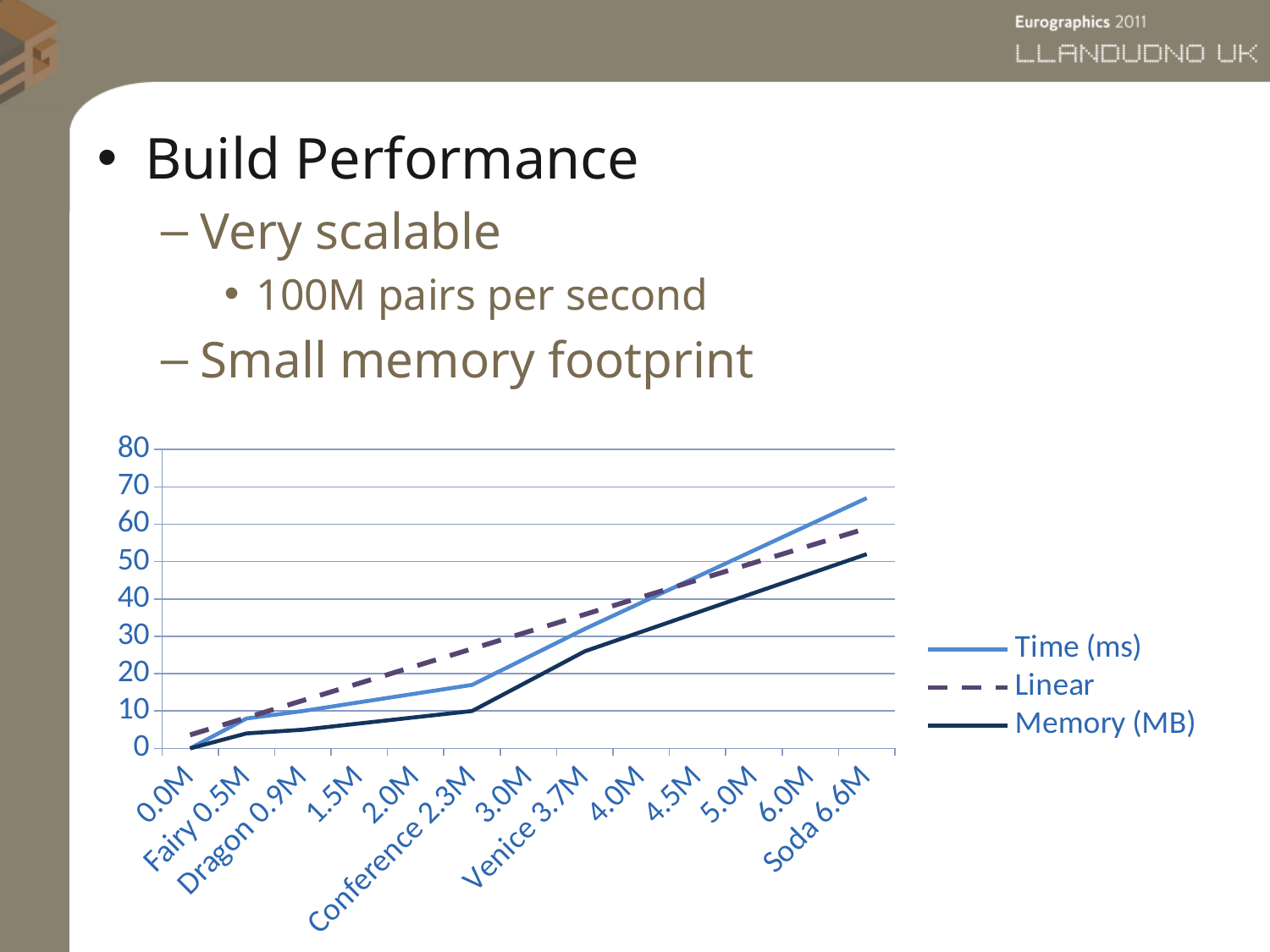
Is the value of Time (ms) at Soda 6.6M greater or less than 60? greater How many categories are shown along the x axis of the chart? 13 Do the values of the Memory (MB) series rise or fall along the x axis? rise At Conference 2.3M, which series has the higher value, Linear or Time (ms)? Linear Is the value of Time (ms) at Conference 2.3M greater or less than 20? less How many series does the chart legend list? 3 Which series is drawn with a dashed line in the chart? Linear What kind of chart is shown on the slide? line chart Is the value of Linear at Venice 3.7M greater or less than 30? greater At Soda 6.6M, which series has the higher value, Time (ms) or Memory (MB)? Time (ms)